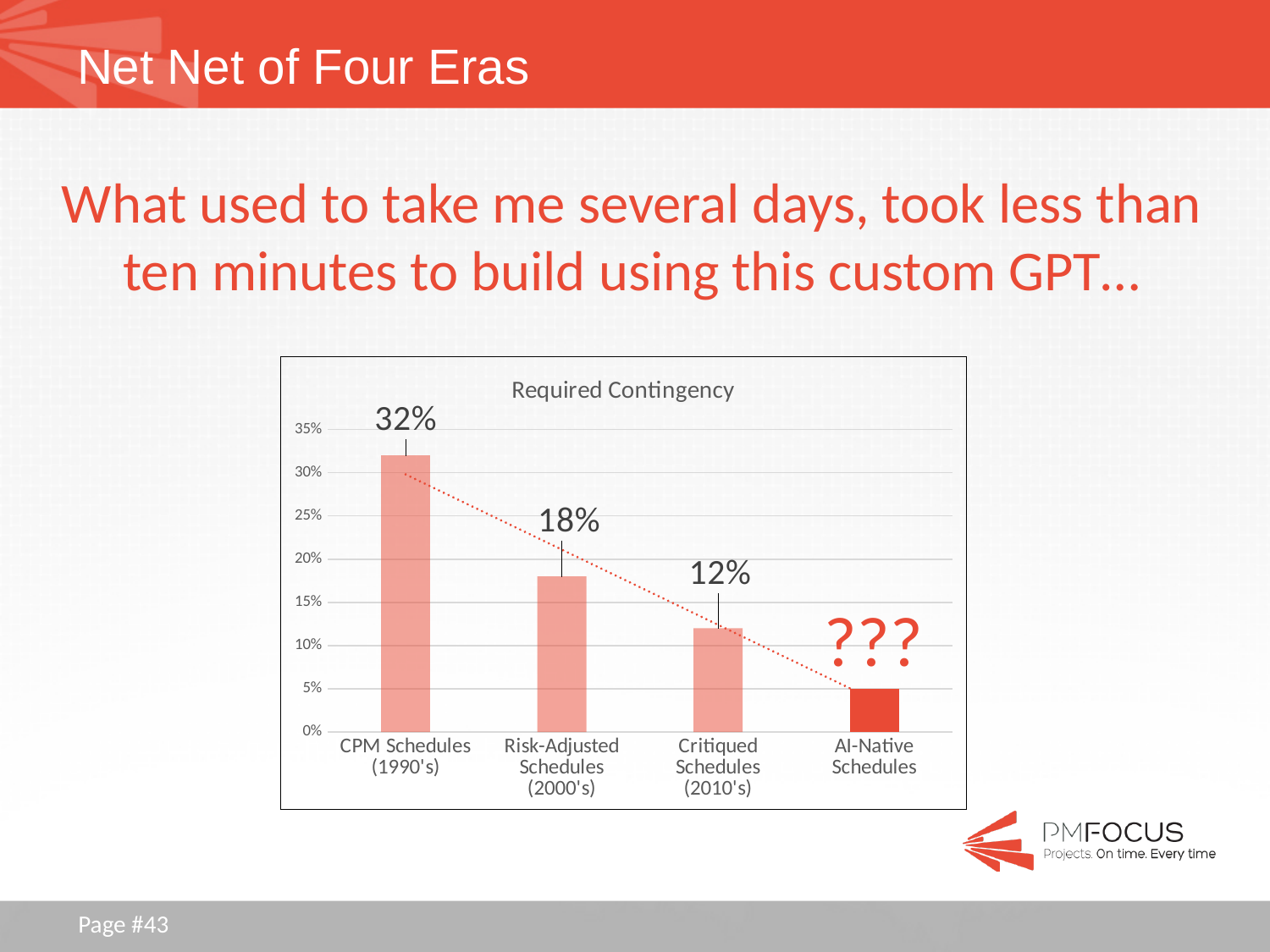
Which category has the lowest bar in the chart? AI-Native Schedules What is the value for Risk-Adjusted Schedules (2000's)? 18% What is the value for Critiqued Schedules (2010's)? 12% Do the values rise or fall from left to right across the categories? fall What is the value for CPM Schedules (1990's) in the Required Contingency chart? 32% How many categories are shown on the x axis of the chart? 4 Which is larger, the value for Risk-Adjusted Schedules (2000's) or Critiqued Schedules (2010's)? Risk-Adjusted Schedules (2000's) Which category has the highest required contingency? CPM Schedules (1990's) What is the difference between the values for CPM Schedules (1990's) and Risk-Adjusted Schedules (2000's)? 14% Is the value for AI-Native Schedules greater or less than 10%? less What kind of chart is shown on the slide? bar chart What is the difference between the values for Risk-Adjusted Schedules (2000's) and Critiqued Schedules (2010's)? 6%